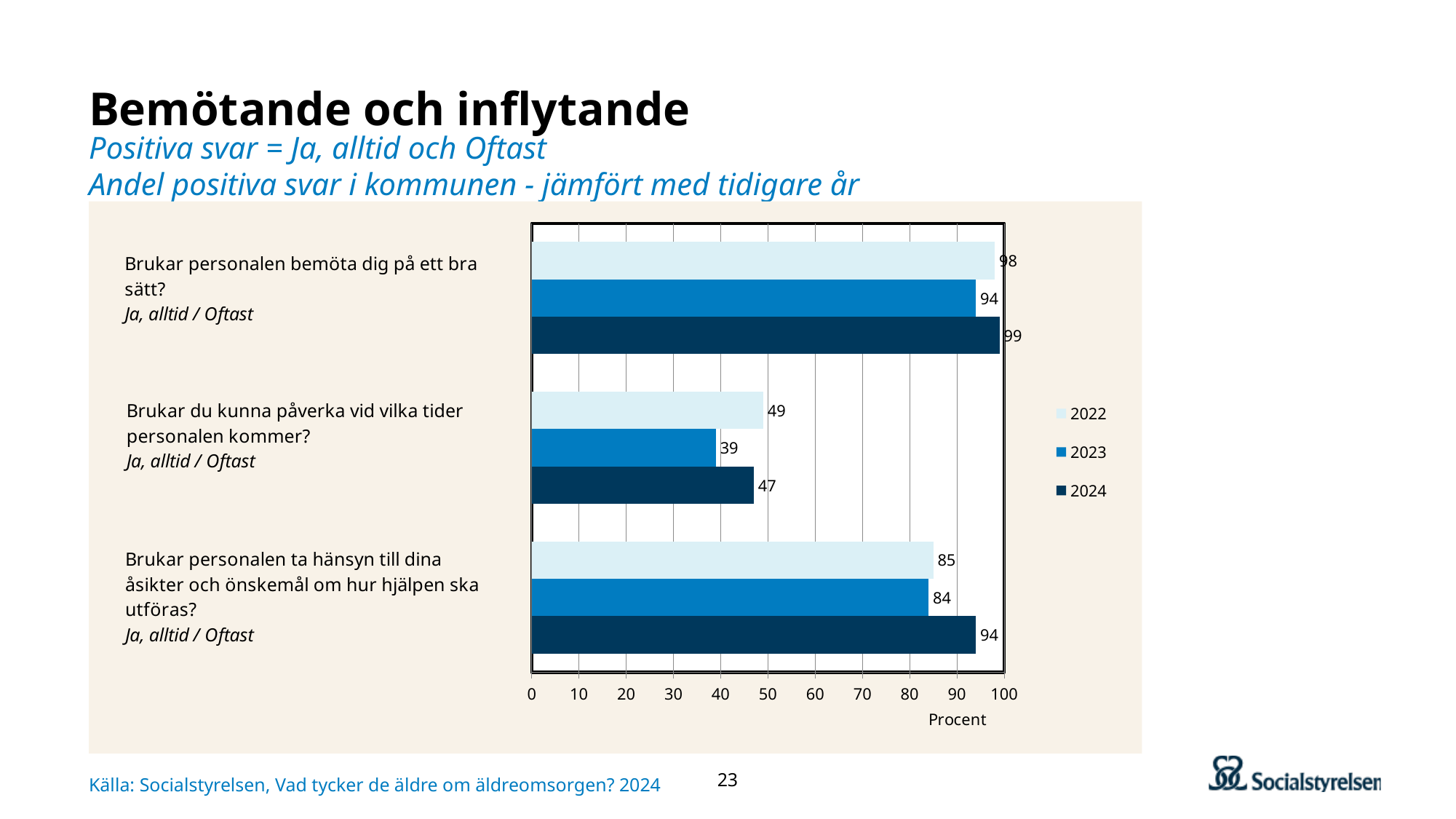
What is the 2024 value for "Brukar personalen bemöta dig på ett bra sätt?"? 99 Which question has the highest 2022 value? Brukar personalen bemöta dig på ett bra sätt? How many series does the legend list? 3 What kind of chart is shown on the slide? Bar chart Which question has the lowest 2024 value? Brukar du kunna påverka vid vilka tider personalen kommer? What is the difference between the 2022 and 2023 values for "Brukar du kunna påverka vid vilka tider personalen kommer?"? 10 What is the 2023 value for "Brukar du kunna påverka vid vilka tider personalen kommer?"? 39 How many question categories are shown in the chart? 3 What is the 2022 value for "Brukar personalen ta hänsyn till dina åsikter och önskemål om hur hjälpen ska utföras?"? 85 For "Brukar du kunna påverka vid vilka tider personalen kommer?", which year has the larger value, 2022 or 2024? 2022 What is the difference between the 2024 and 2023 values for "Brukar personalen ta hänsyn till dina åsikter och önskemål om hur hjälpen ska utföras?"? 10 What is the label on the horizontal axis of the chart? Procent